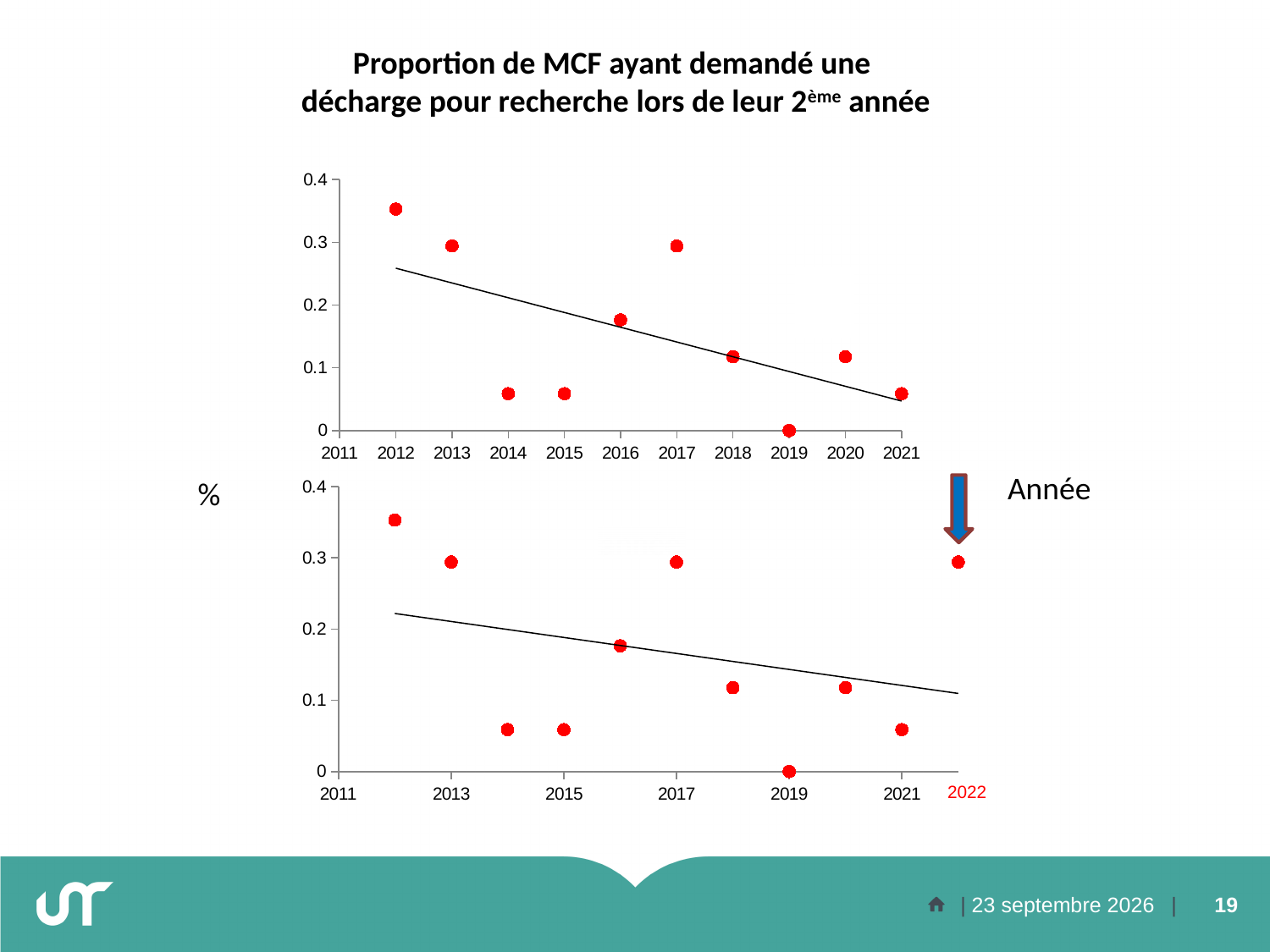
According to the trend line in the top chart, do the values rise or fall from 2012 to 2021? fall What kind of chart is the top chart on the slide? scatter chart What is the last year shown on the x axis of the bottom chart? 2022 In the top chart, which is larger, the value for 2016 or the value for 2018? 2016 In the bottom chart, is the value for 2022 greater or less than 0.2? greater How many data points are plotted in the bottom chart? 11 In the top chart, is the value for 2012 greater or less than 0.3? greater How many data points are plotted in the top chart? 10 In the top chart, which year has the lowest value? 2019 In the top chart, which year has the highest value? 2012 In the top chart, what is the value for 2019? 0 In the top chart, is the value for 2014 greater or less than 0.1? less